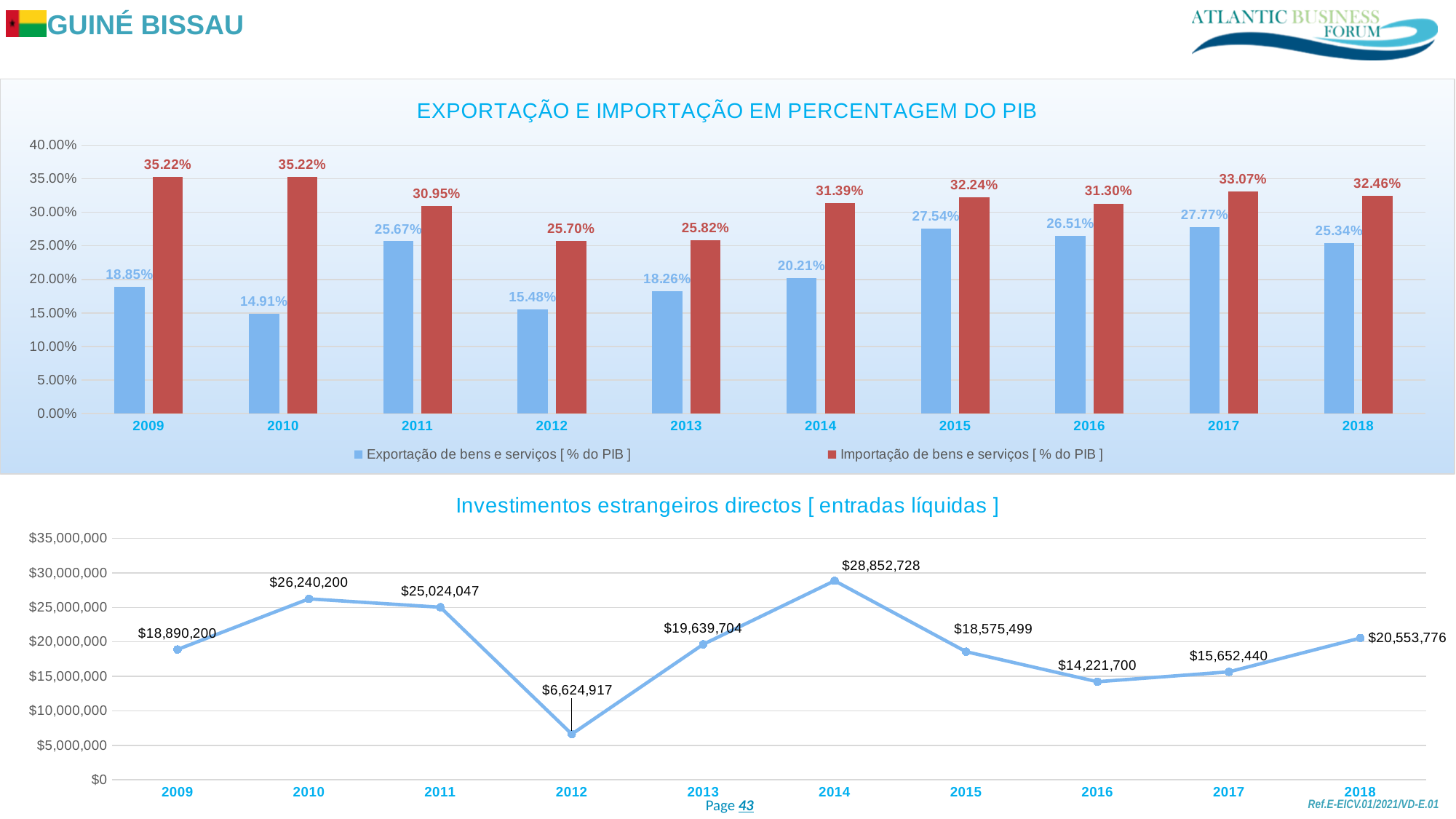
In the chart 'EXPORTAÇÃO E IMPORTAÇÃO EM PERCENTAGEM DO PIB', how many series does the legend list? 2 In the chart 'EXPORTAÇÃO E IMPORTAÇÃO EM PERCENTAGEM DO PIB', what is the value of Importação de bens e serviços for 2017? 33.07% In the chart 'EXPORTAÇÃO E IMPORTAÇÃO EM PERCENTAGEM DO PIB', which year has the lowest value for Exportação de bens e serviços? 2010 In the chart 'Investimentos estrangeiros directos [ entradas líquidas ]', what is the difference between the 2010 and 2009 values? $7,350,000 What kind of chart is 'EXPORTAÇÃO E IMPORTAÇÃO EM PERCENTAGEM DO PIB'? Bar chart In the chart 'Investimentos estrangeiros directos [ entradas líquidas ]', how many years are plotted? 10 In the chart 'Investimentos estrangeiros directos [ entradas líquidas ]', what is the value for 2013? $19,639,704 In the chart 'EXPORTAÇÃO E IMPORTAÇÃO EM PERCENTAGEM DO PIB', which year has the highest value for Exportação de bens e serviços? 2017 In the chart 'EXPORTAÇÃO E IMPORTAÇÃO EM PERCENTAGEM DO PIB', what is the difference between Importação and Exportação in 2018? 7.12% In the chart 'EXPORTAÇÃO E IMPORTAÇÃO EM PERCENTAGEM DO PIB', what is the value of Exportação de bens e serviços for 2011? 25.67% In the chart 'Investimentos estrangeiros directos [ entradas líquidas ]', which year has the lowest value? 2012 In the chart 'Investimentos estrangeiros directos [ entradas líquidas ]', which year has the highest value? 2014